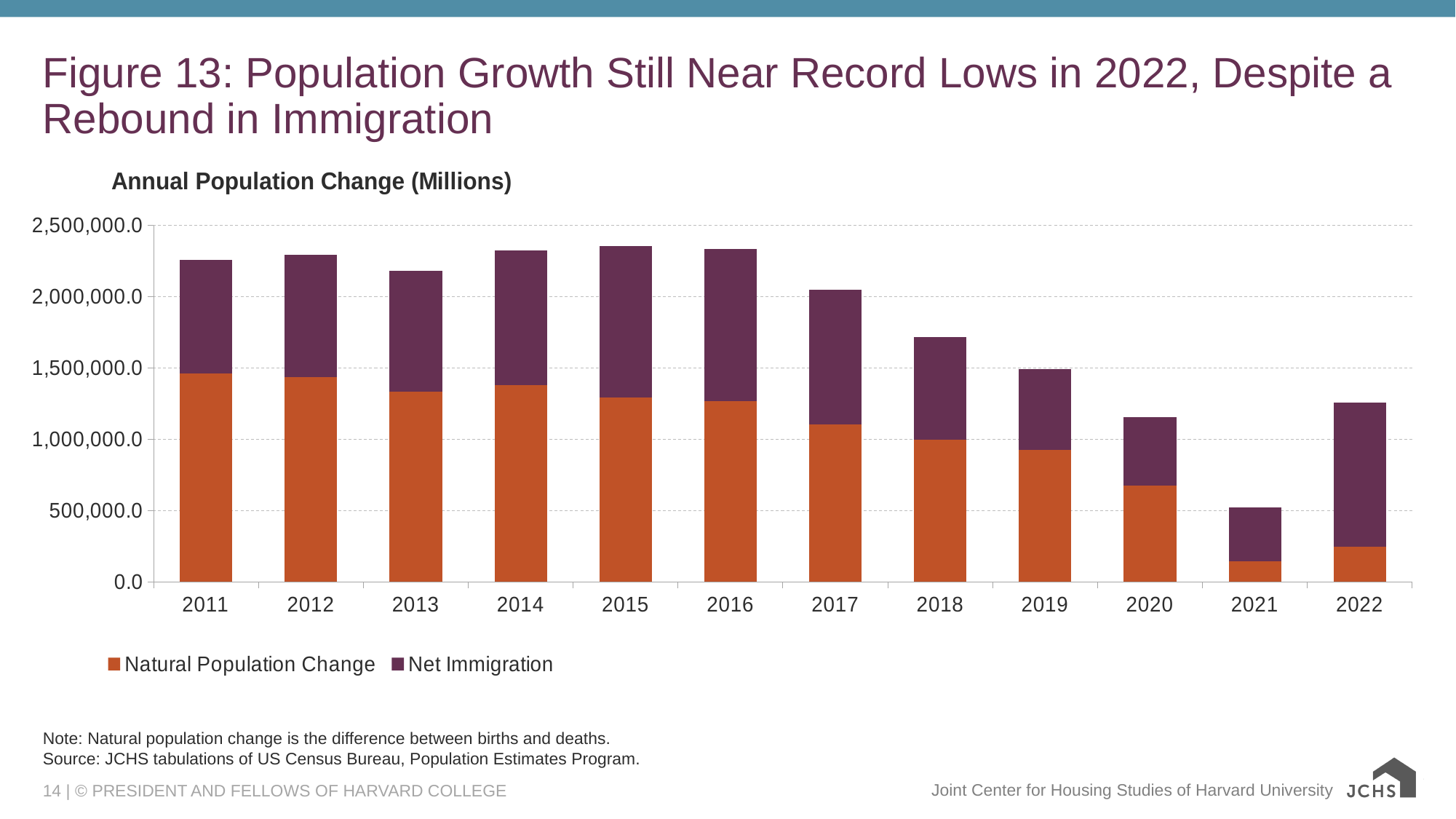
Does the total annual population change rise or fall from 2016 to 2021? Fall Is the Natural Population Change for 2022 greater or less than 500,000? less Which year has the larger total annual population change, 2019 or 2020? 2019 Is the total annual population change for 2021 greater or less than 1,000,000? less Which year has the lowest total annual population change? 2021 How many years are shown on the x axis of the chart? 12 Which series is shown in orange in the chart's legend? Natural Population Change How many series does the chart's legend list? 2 Which year has the lowest Natural Population Change? 2021 Is the total annual population change for 2022 greater or less than 1,000,000? greater What kind of chart is shown on the slide? Stacked bar chart